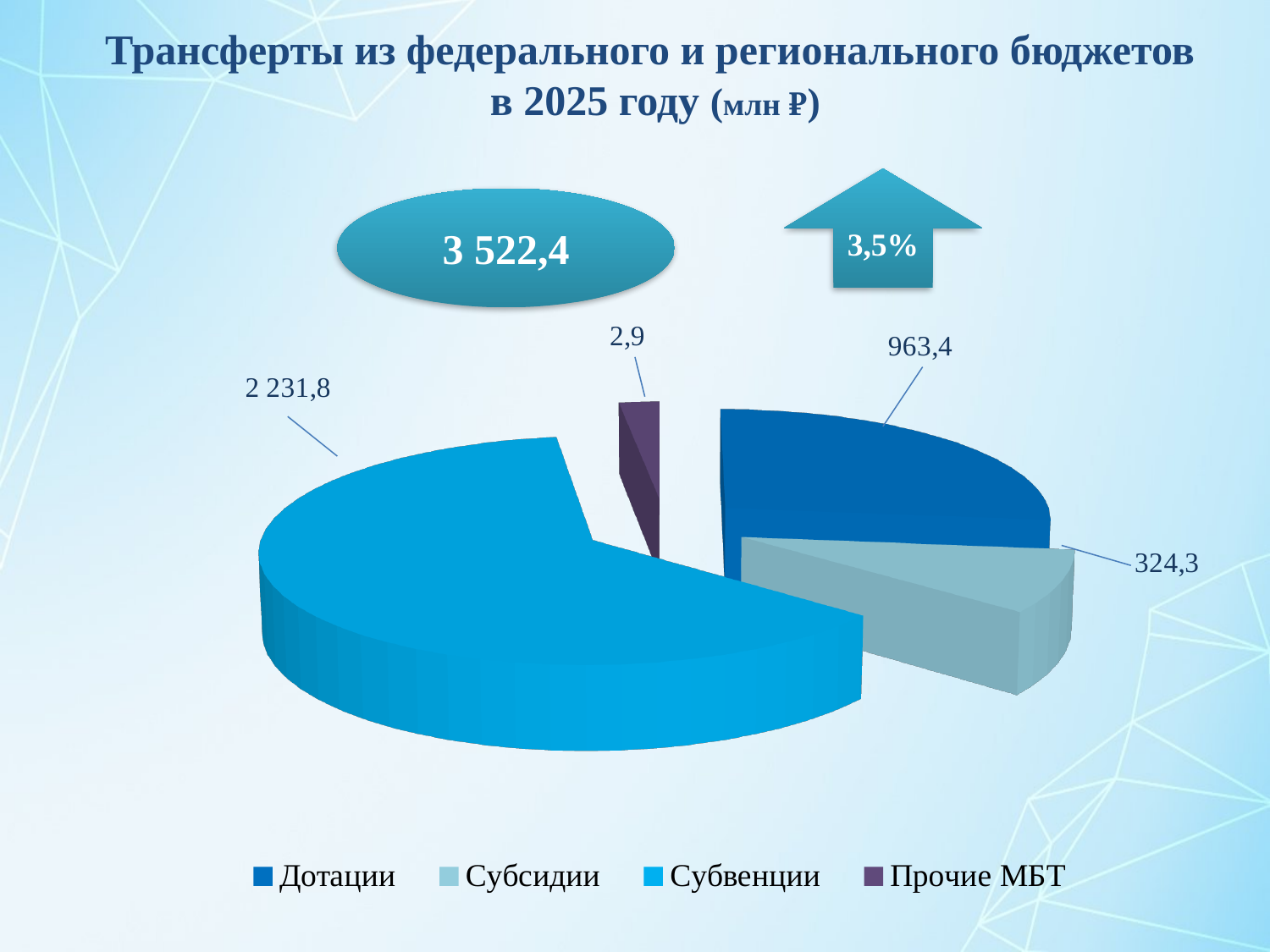
Which is larger, Дотации or Субсидии? Дотации Which category has the largest slice of the pie? Субвенции What is the value for Дотации? 963,4 How many categories does the pie chart show? 4 What kind of chart is shown on the slide? Pie chart What total value is shown in the oval above the chart? 3 522,4 What percentage is shown inside the arrow on the slide? 3,5% Which category has the smallest slice of the pie? Прочие МБТ What is the difference between the values for Дотации and Субсидии? 639,1 What is the value for Субсидии? 324,3 What is the value for Прочие МБТ? 2,9 What is the value for Субвенции? 2 231,8